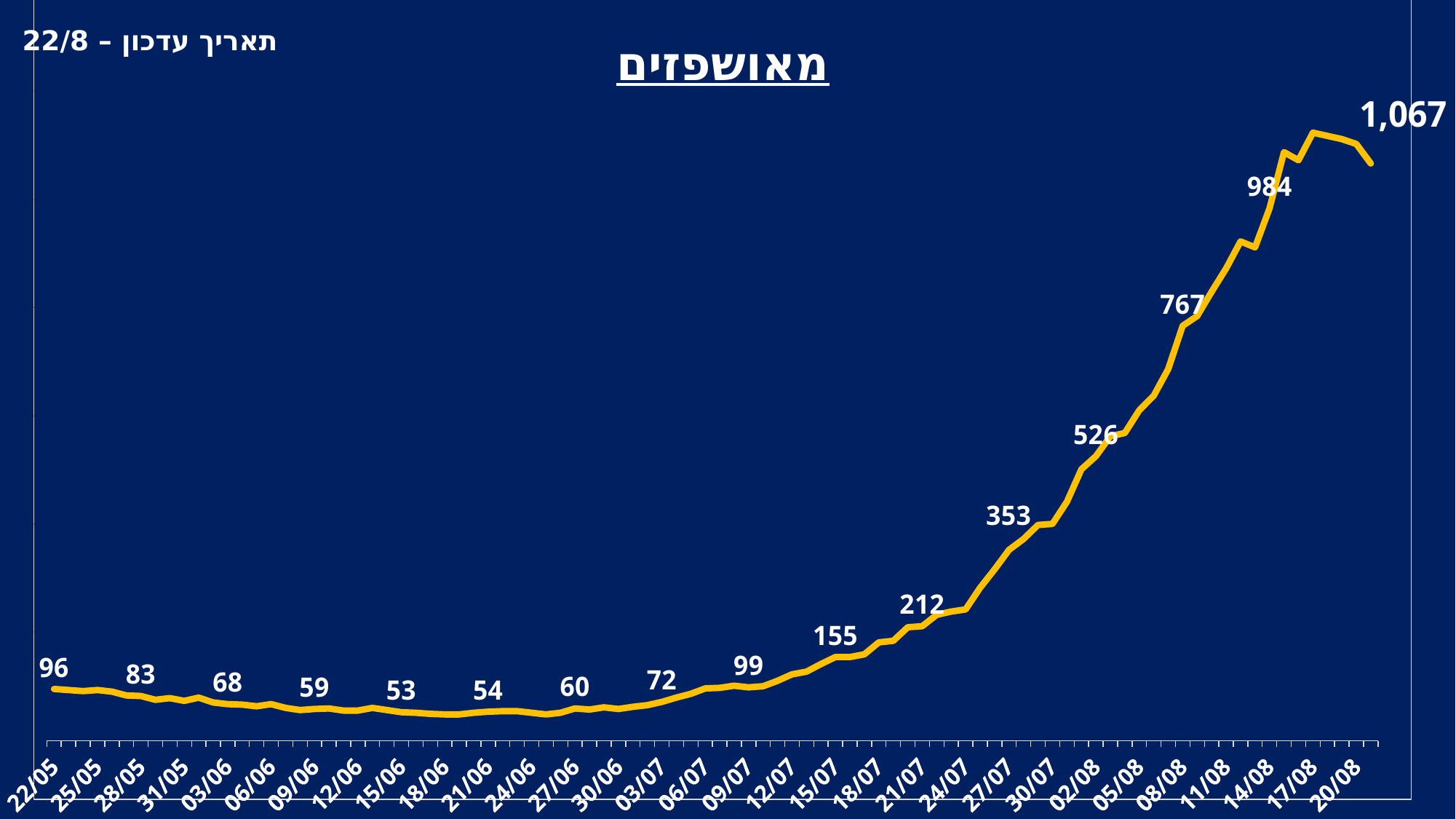
Which labelled value is larger, 353 or 212? 353 What is the data label shown at 15/07? 155 What is the value of the first data label on the line, at 22/05? 96 What is the highest value labelled on the chart? 1,067 What is the lowest value labelled on the chart? 53 What is the difference between the labelled values 984 and 767? 217 How many data labels are printed along the line? 16 What kind of chart is shown on the slide? line chart What is the title of the chart? מאושפזים What is the difference between the highest labelled value (1,067) and the first labelled value (96)? 971 What update date is shown in the top-left corner of the slide? 22/8 What is the data label shown at 28/05? 83